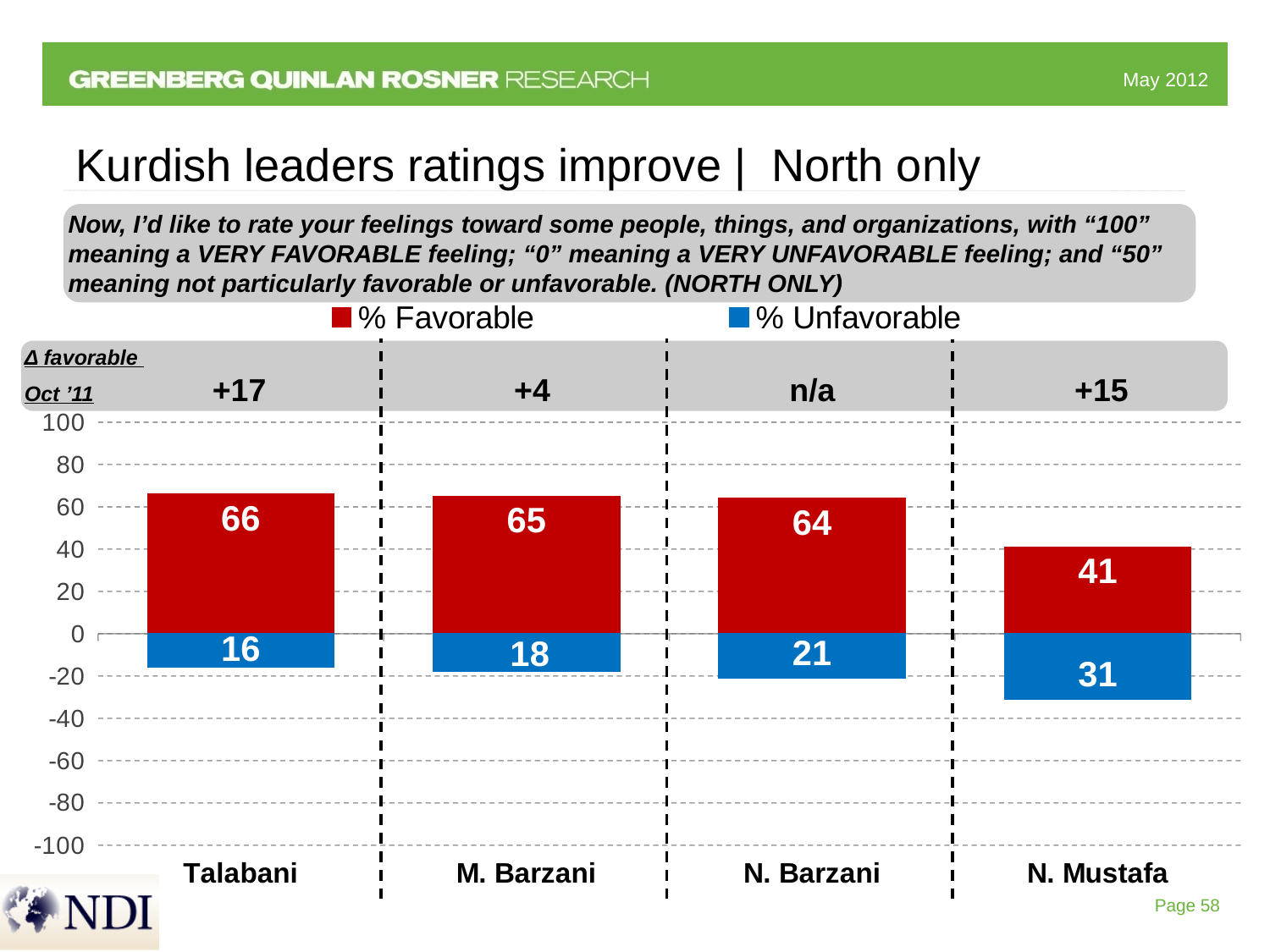
Which leader has the highest % Unfavorable rating? N. Mustafa What is the Δ favorable since Oct '11 shown for Talabani? +17 Which leader has the lowest % Favorable rating? N. Mustafa Is the % Unfavorable value larger for N. Barzani or for Talabani? N. Barzani What is the % Unfavorable value for N. Barzani? 21 How many leaders are shown on the chart? 4 What kind of chart is shown on the slide? Bar chart What is the % Unfavorable value for N. Mustafa? 31 What is the difference between the % Favorable and % Unfavorable values for M. Barzani? 47 Which leader has the highest % Favorable rating? Talabani How many series does the legend list? 2 What is the % Favorable value for Talabani? 66